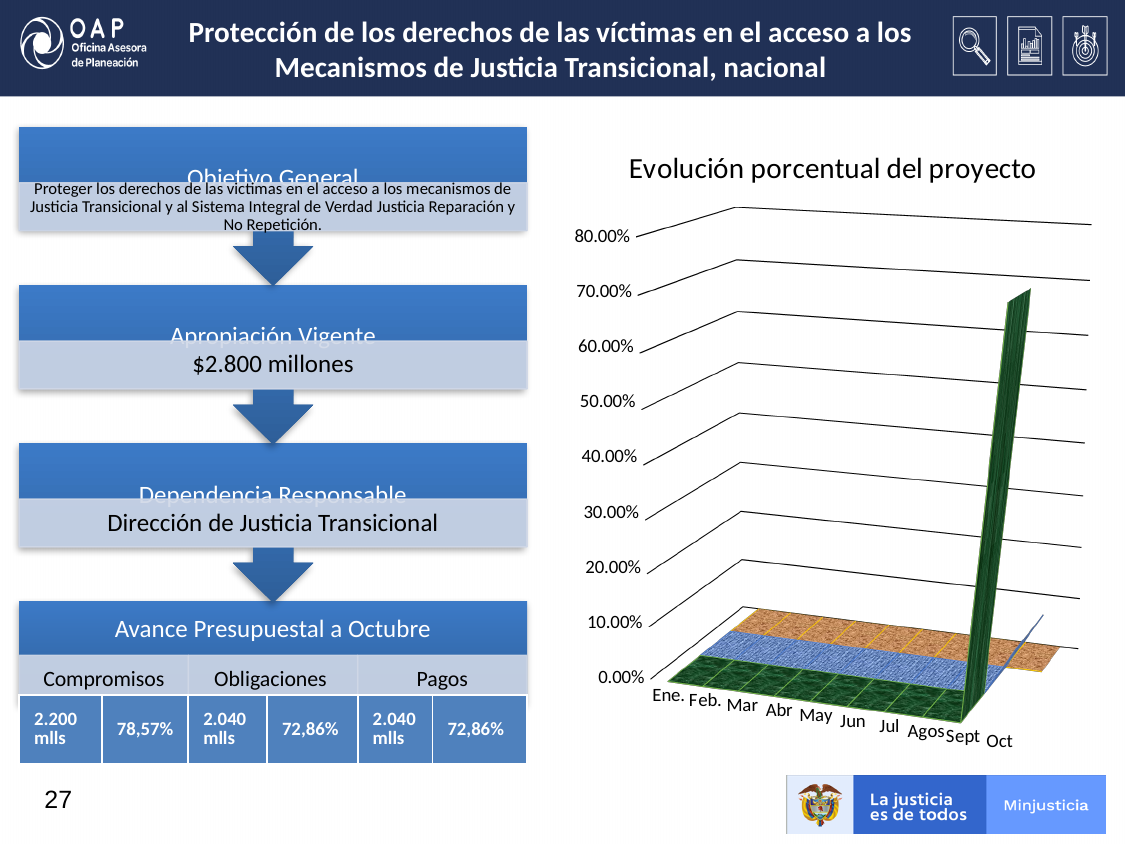
Which month has a larger value, Oct or Jun? Oct Is the peak value in Oct greater or less than 40.00%? greater What is the highest value shown on the vertical axis of the chart? 80.00% What kind of chart is shown on the slide? line chart What is the first month label on the x axis of the chart? Ene. Do the values in the chart rise or fall toward the end of the x axis? rise What is the title of the chart on the slide? Evolución porcentual del proyecto How many months are shown along the x axis of the chart? 10 Which month shows the highest value in the chart? Oct Is the value for Ene. greater or less than 10.00%? less